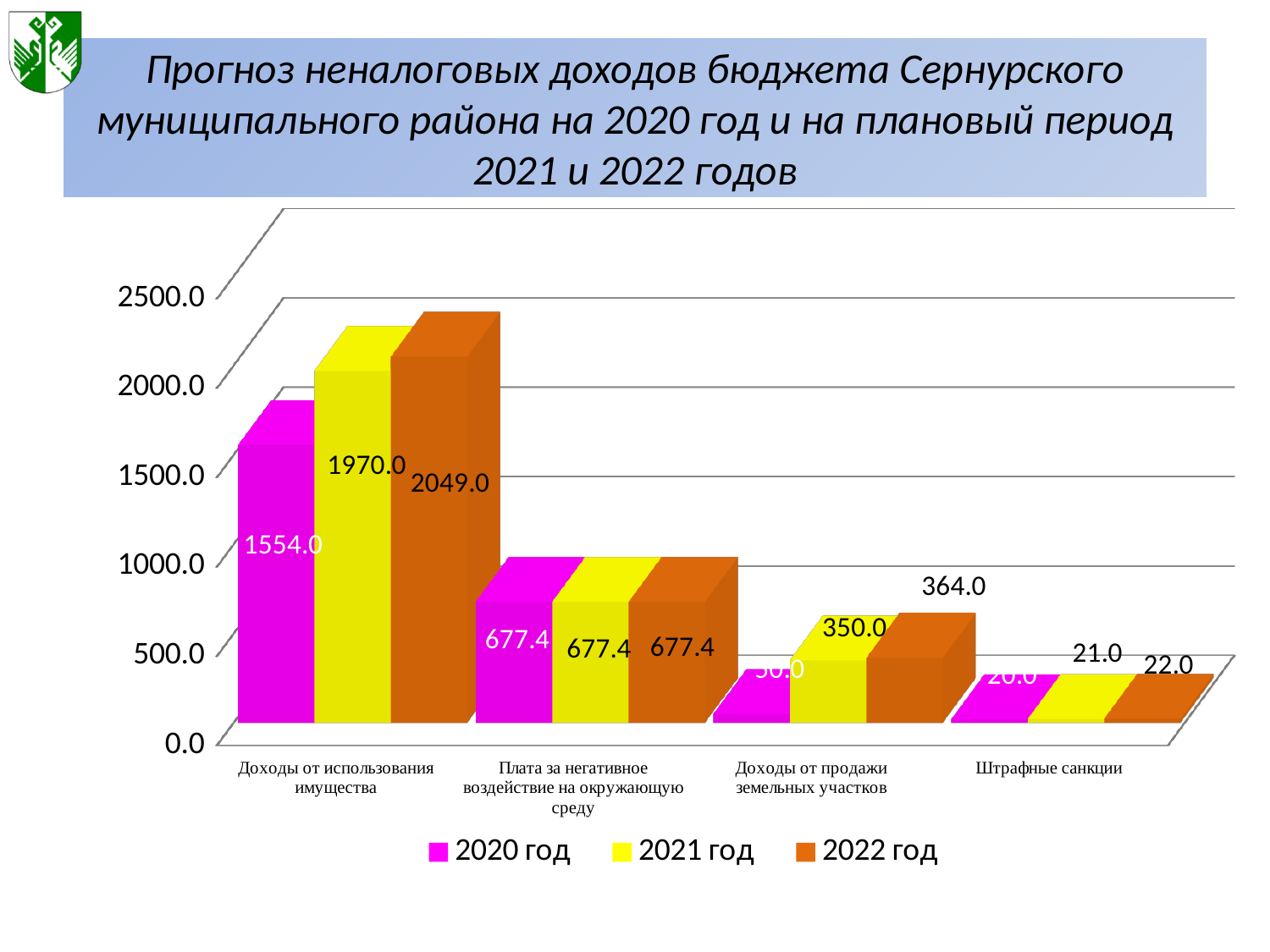
What is the value for 2022 год for Доходы от продажи земельных участков? 364.0 What is the value for 2021 год for Штрафные санкции? 21.0 Which category has the lowest value for 2021 год? Штрафные санкции What kind of chart is shown on the slide? Bar chart How many series does the legend list? 3 Which category has the highest value for 2022 год? Доходы от использования имущества What is the value for 2021 год for Доходы от использования имущества? 1970.0 Which is larger for Доходы от продажи земельных участков: the 2021 год value or the 2022 год value? 2022 год What is the value for 2020 год for Доходы от использования имущества? 1554.0 How many categories are shown on the x axis? 4 What is the difference between the 2022 год and 2021 год values for Доходы от использования имущества? 79.0 What is the value for 2022 год for Доходы от использования имущества? 2049.0